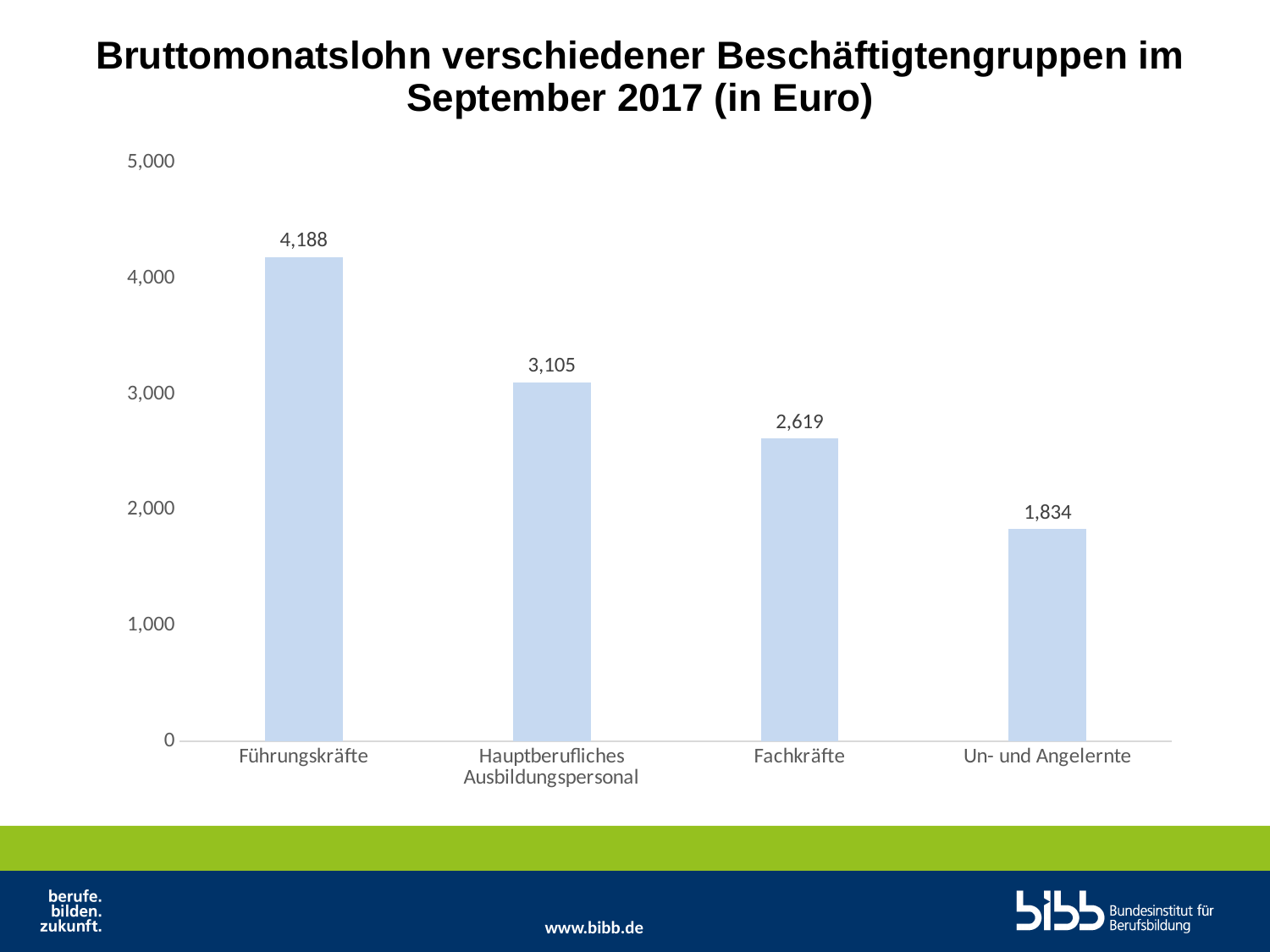
Which is larger, the value for Fachkräfte or the value for Un- und Angelernte? Fachkräfte What is the value for Un- und Angelernte? 1,834 How many categories are shown on the x axis? 4 What is the value for Hauptberufliches Ausbildungspersonal? 3,105 What is the value for Führungskräfte? 4,188 What is the difference between the values for Hauptberufliches Ausbildungspersonal and Fachkräfte? 486 What is the difference between the values for Führungskräfte and Un- und Angelernte? 2,354 Which category has the lowest value? Un- und Angelernte Which category has the highest value? Führungskräfte Do the values rise or fall from left to right along the x axis? fall What is the value for Fachkräfte? 2,619 What kind of chart is shown on the slide? bar chart